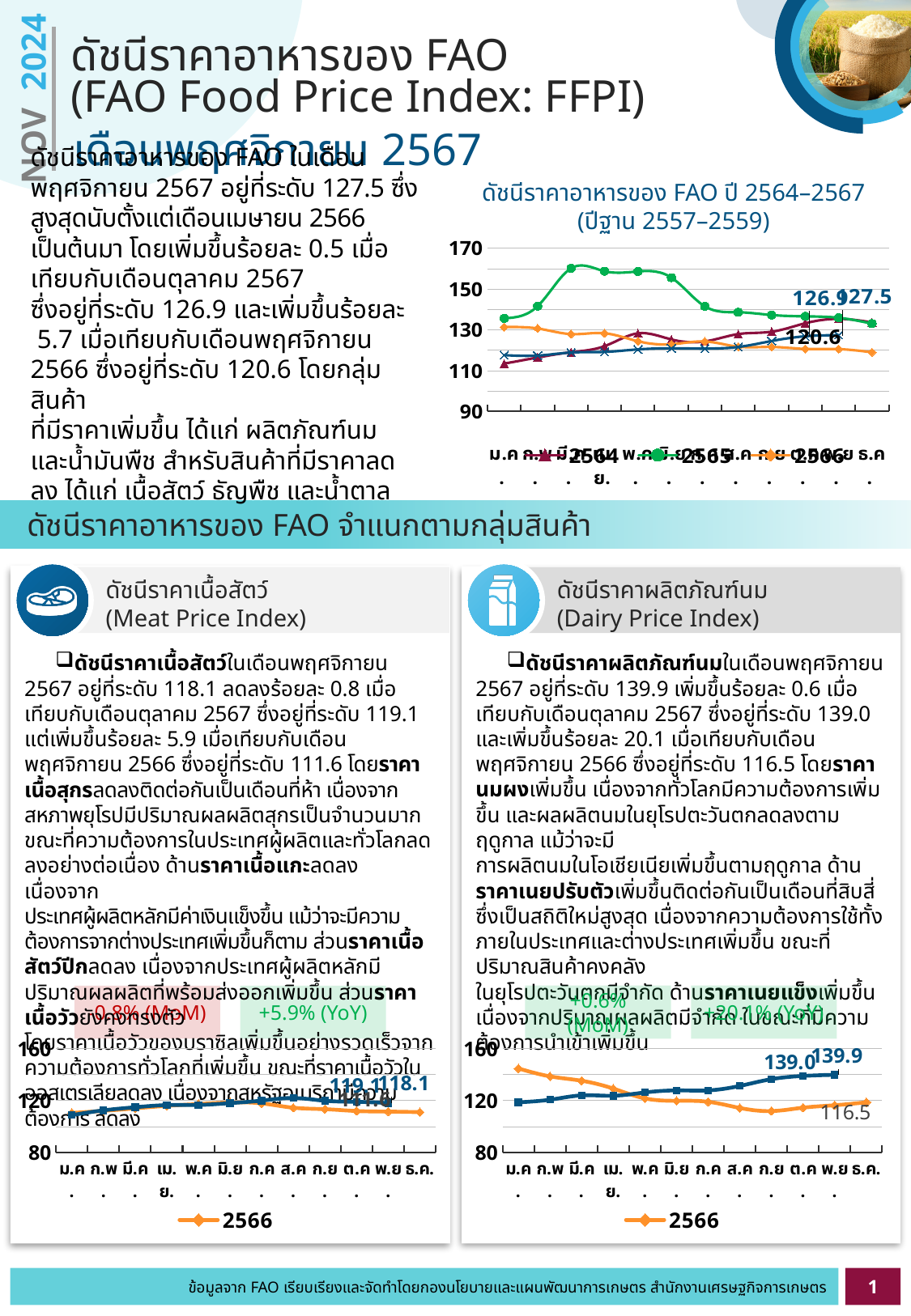
In the Meat Price Index chart (bottom left), what value is labelled for October 2567? 119.1 In the 'ดัชนีราคาอาหารของ FAO ปี 2564–2567' chart, is the peak of the 2565 series greater or less than 150? greater In the Dairy Price Index chart (bottom right), what is the difference between the labelled November 2567 value (139.9) and the labelled November 2566 value (116.5)? 23.4 What kind of chart is the 'ดัชนีราคาอาหารของ FAO ปี 2564–2567' chart at the top right? line chart In the 'ดัชนีราคาอาหารของ FAO ปี 2564–2567' chart, what value is labelled for November 2566? 120.6 In the Meat Price Index chart (bottom left), what value is labelled for November 2567? 118.1 In the Dairy Price Index chart (bottom right), what value is labelled for November 2567? 139.9 In the 'ดัชนีราคาอาหารของ FAO ปี 2564–2567' chart, what value is labelled for November 2567 (พ.ย.)? 127.5 In the Dairy Price Index chart (bottom right), which is larger: the labelled October 2567 value or the labelled November 2567 value? November 2567 (139.9) In the 'ดัชนีราคาอาหารของ FAO ปี 2564–2567' chart, what value is labelled for October 2567 (ต.ค.)? 126.9 In the 'ดัชนีราคาอาหารของ FAO ปี 2564–2567' chart, what is the difference between the labelled November 2567 value (127.5) and the labelled November 2566 value (120.6)? 6.9 In the 'ดัชนีราคาอาหารของ FAO ปี 2564–2567' chart, what is the highest value shown on the vertical axis? 170